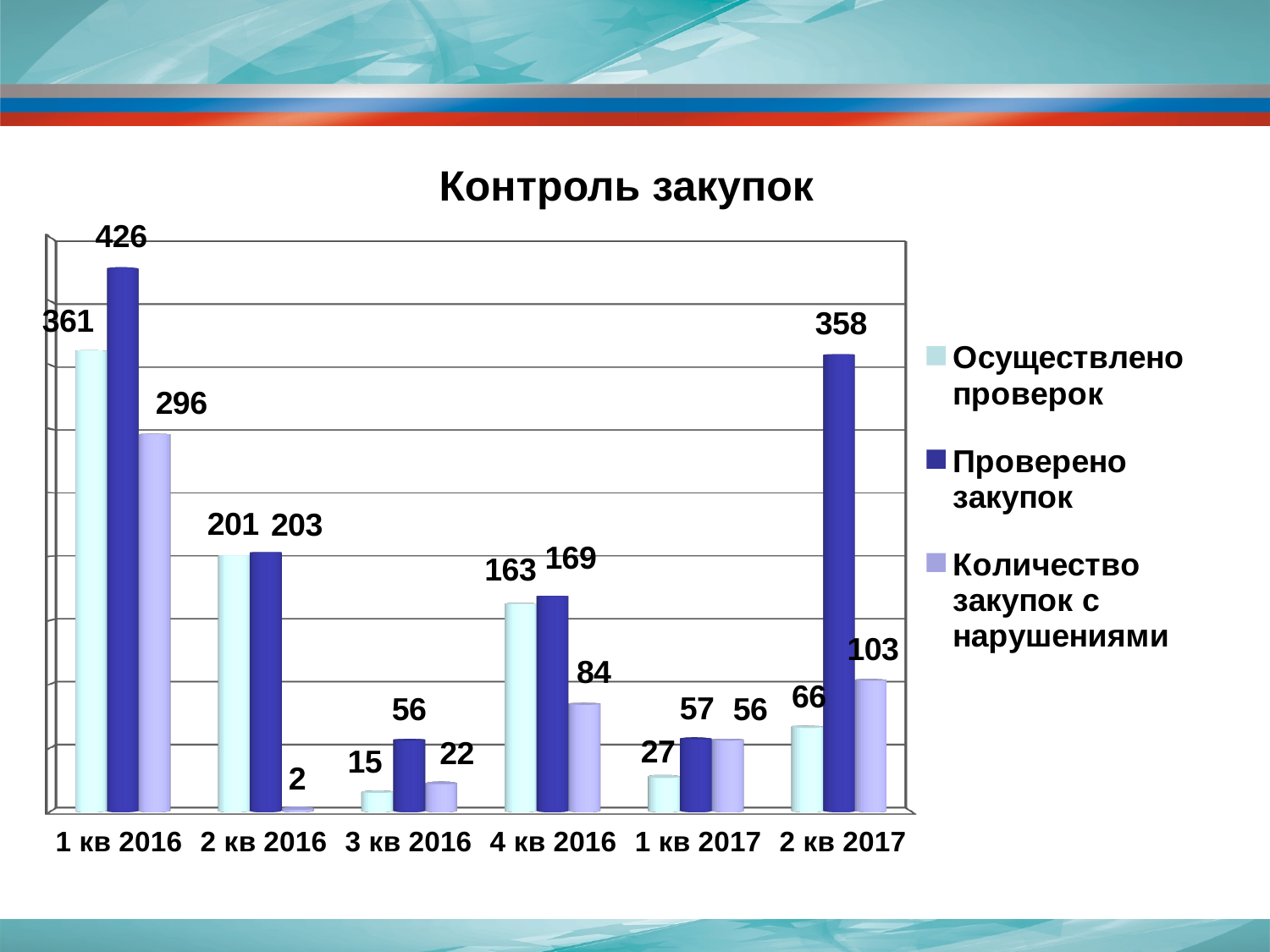
What is the value of Количество закупок с нарушениями for 2 кв 2016? 2 In which quarter is Осуществлено проверок the highest? 1 кв 2016 Which is larger for 4 кв 2016: Осуществлено проверок or Количество закупок с нарушениями? Осуществлено проверок How many quarters (categories) are shown on the x axis? 6 What type of chart is shown on the slide? Bar chart What is the value of Проверено закупок for 1 кв 2016? 426 How many series does the legend list? 3 What is the title of the chart? Контроль закупок What is the value of Осуществлено проверок for 2 кв 2017? 66 What is the difference between Проверено закупок and Осуществлено проверок for 2 кв 2017? 292 In which quarter is Проверено закупок the lowest? 3 кв 2016 Do the values of Осуществлено проверок rise or fall from 1 кв 2016 to 3 кв 2016? Fall